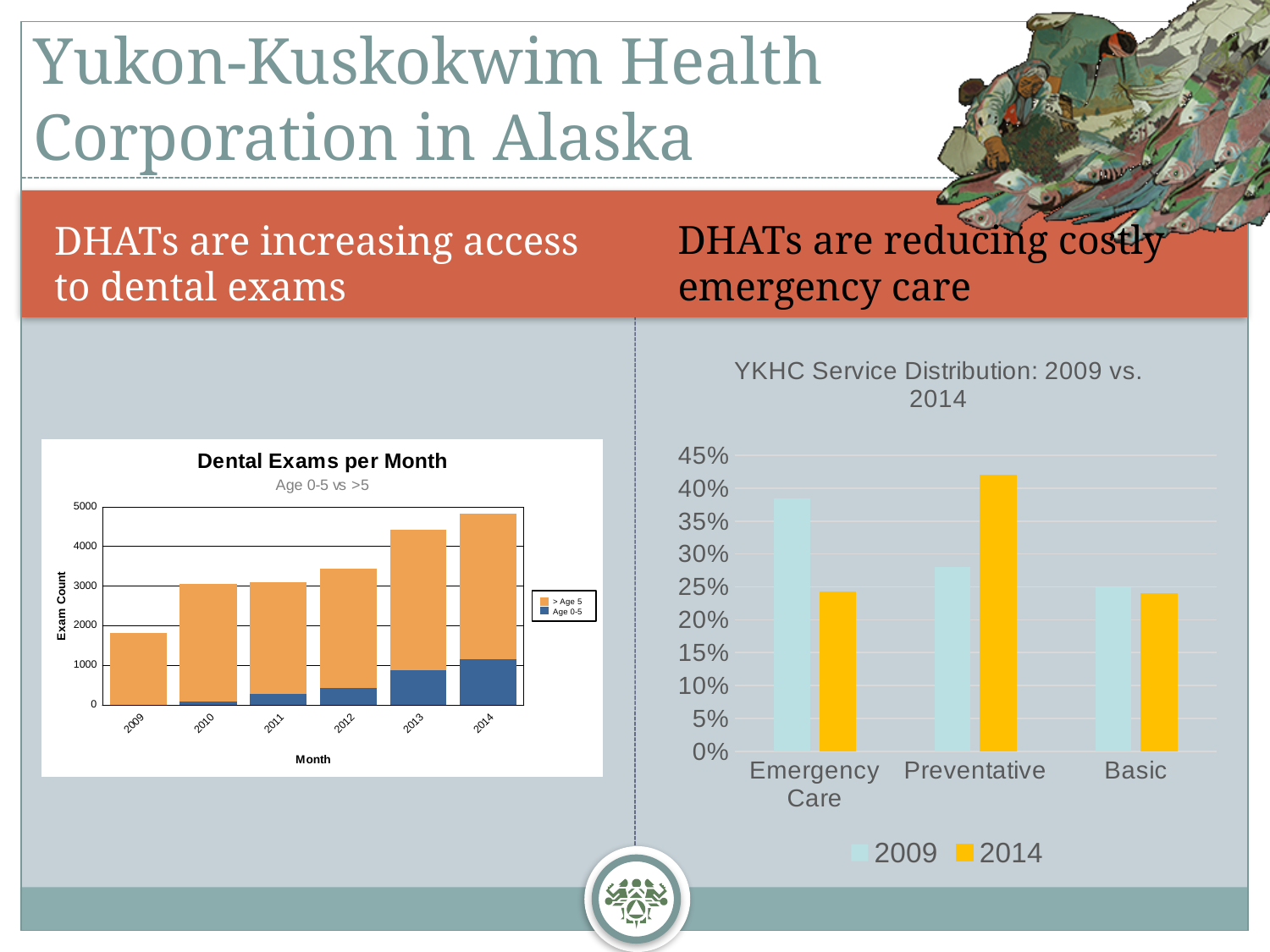
What type of chart is the 'YKHC Service Distribution: 2009 vs. 2014' chart on the right? Bar chart How many categories are shown on the x axis of the 'YKHC Service Distribution: 2009 vs. 2014' chart? 3 In the 'YKHC Service Distribution: 2009 vs. 2014' chart, is the 2009 value for Emergency Care greater or less than 35%? greater In the 'YKHC Service Distribution: 2009 vs. 2014' chart, which category has the highest 2009 value? Emergency Care In the 'Dental Exams per Month' chart, do the total exam counts rise or fall from 2009 to 2014? Rise In the 'YKHC Service Distribution: 2009 vs. 2014' chart, is the Emergency Care value larger in 2009 or 2014? 2009 How many series does the legend list in the 'Dental Exams per Month' chart on the left? 2 In the 'YKHC Service Distribution: 2009 vs. 2014' chart, which category has the highest 2014 value? Preventative In the 'Dental Exams per Month' chart, is the total exam count for 2009 greater or less than 2000? less In the 'YKHC Service Distribution: 2009 vs. 2014' chart, is the Preventative value larger in 2009 or 2014? 2014 In the 'YKHC Service Distribution: 2009 vs. 2014' chart, is the 2014 value for Preventative greater or less than 40%? greater How many years are shown on the x axis of the 'Dental Exams per Month' chart? 6